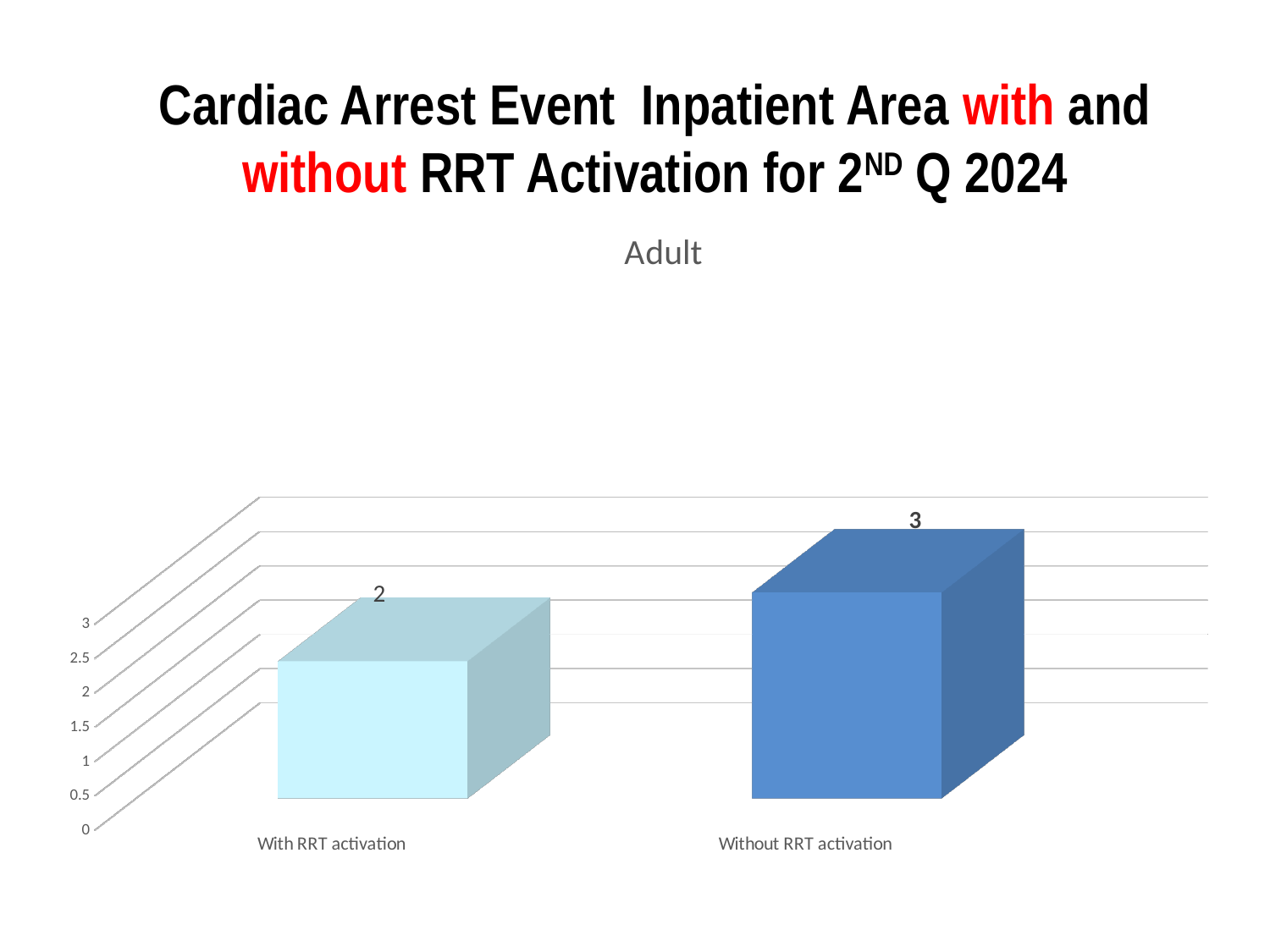
Which category has the highest value? Without RRT activation What kind of chart is shown on the slide? bar chart Which is larger, the value for With RRT activation or the value for Without RRT activation? Without RRT activation What is the difference between the values for Without RRT activation and With RRT activation? 1 Which category has the lowest value? With RRT activation How many categories are shown on the chart? 2 What is the value for Without RRT activation? 3 What is the highest value shown on the vertical axis? 3 What is the value for With RRT activation? 2 Is the value for Without RRT activation greater or less than 2.5? greater What is the title of the chart? Adult